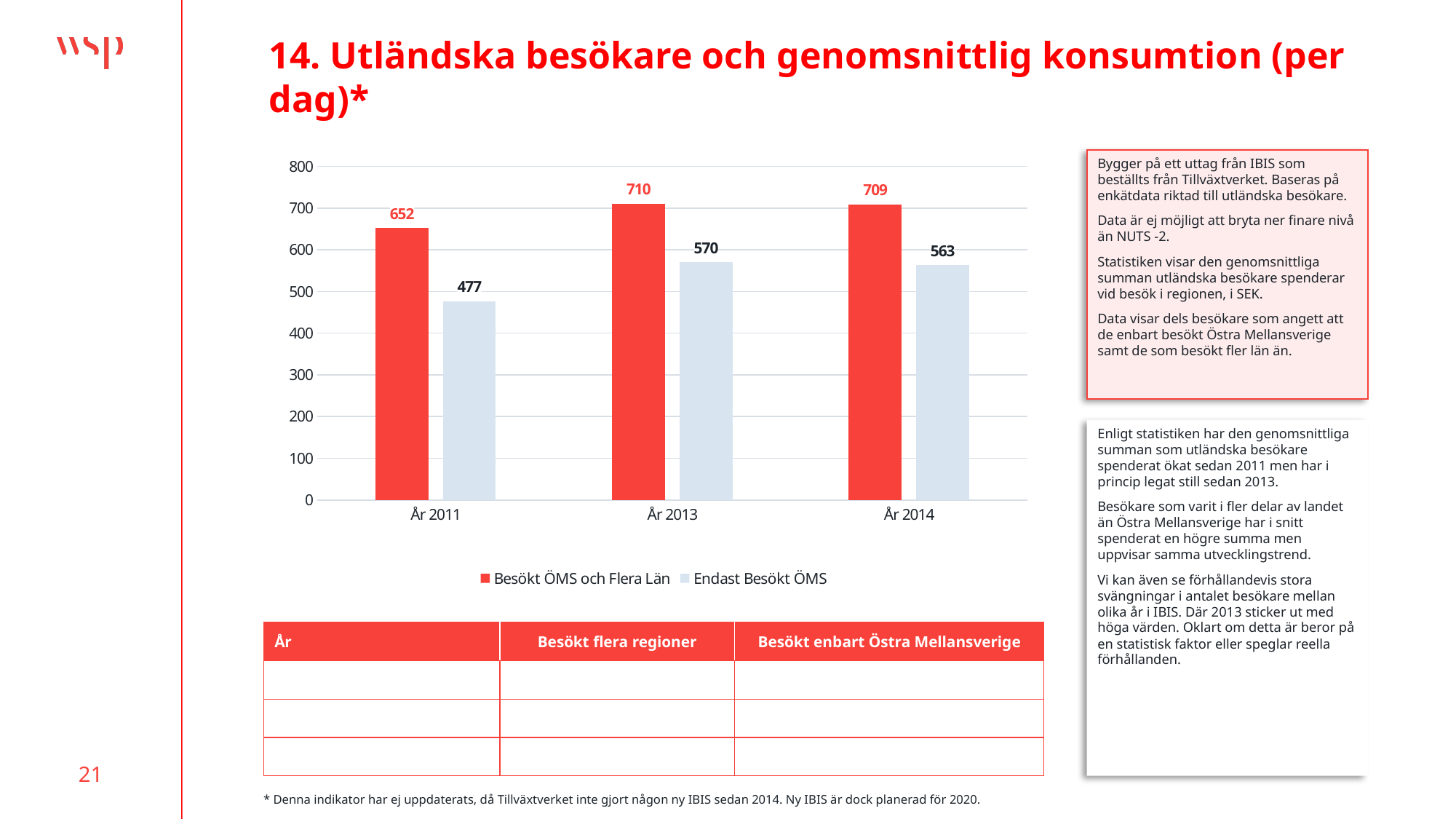
Is the value for 'Endast Besökt ÖMS' in År 2011 greater or less than 500? less Which year has the lowest value for 'Endast Besökt ÖMS'? År 2011 How many years are shown on the x axis? 3 Which year has the highest value for 'Besökt ÖMS och Flera Län'? År 2013 What is the difference between the 'Endast Besökt ÖMS' values for År 2013 and År 2011? 93 What is the difference between 'Besökt ÖMS och Flera Län' and 'Endast Besökt ÖMS' in År 2011? 175 What is the value for 'Besökt ÖMS och Flera Län' in År 2011? 652 What is the value for 'Endast Besökt ÖMS' in År 2013? 570 What is the value for 'Endast Besökt ÖMS' in År 2014? 563 What kind of chart is shown on the slide? bar chart Which is larger in År 2014: 'Besökt ÖMS och Flera Län' or 'Endast Besökt ÖMS'? Besökt ÖMS och Flera Län How many series does the legend list? 2